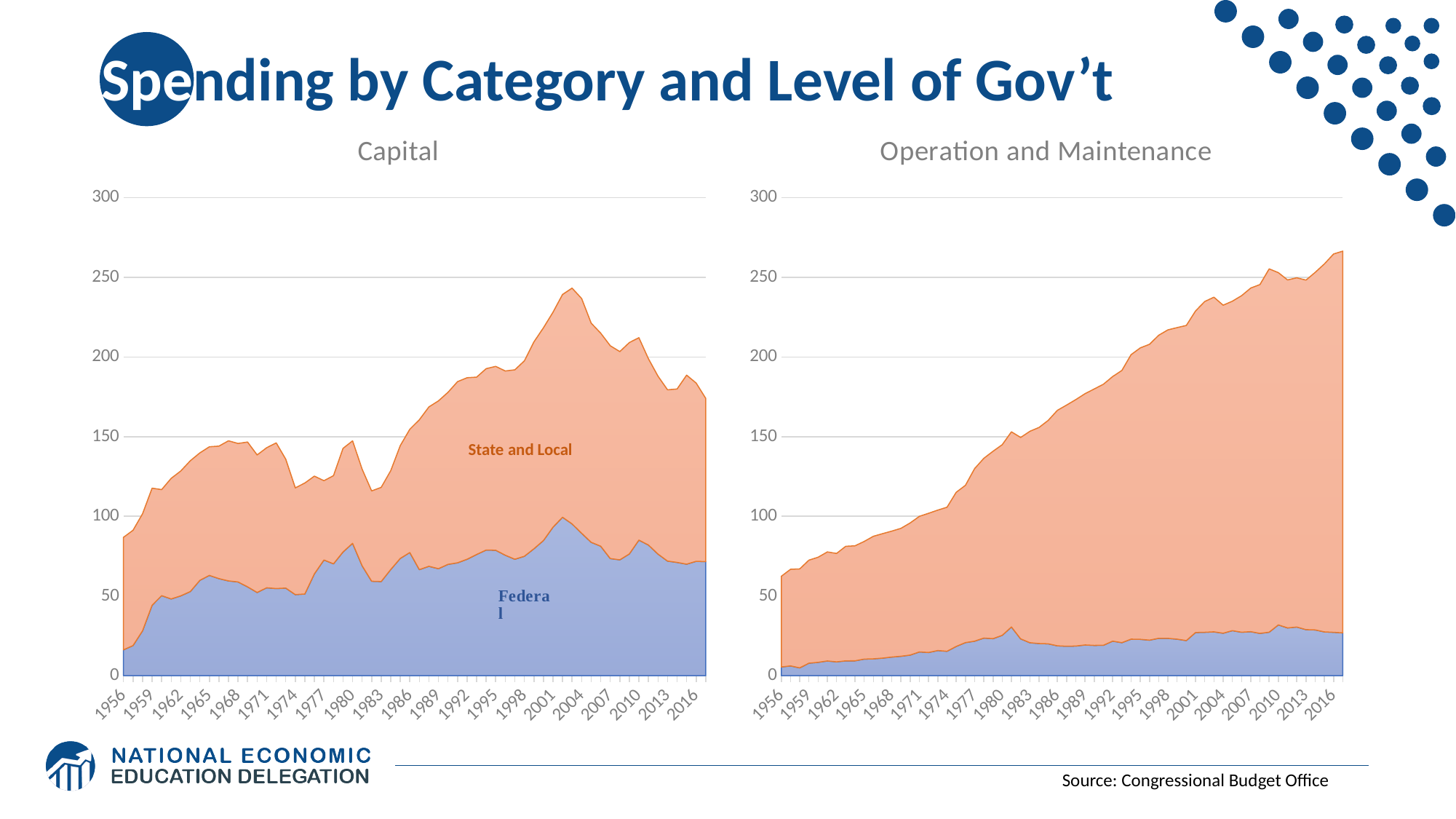
In the Capital chart, is the total (top of the stacked area) in 2004 greater or less than 200? greater In the Capital chart, is the Federal value in 2016 greater or less than 50? greater In the Capital chart, which series is larger in 2016, State and Local or Federal? State and Local In the Operation and Maintenance chart, is the Federal value in 2016 greater or less than 50? less What kind of chart is the Capital chart? stacked area chart How many series are shown in the Capital chart? 2 What is the title of the right-hand chart? Operation and Maintenance Which chart shows the larger total in 2016, Capital or Operation and Maintenance? Operation and Maintenance In the Capital chart, which two series are labelled? State and Local, Federal In the Operation and Maintenance chart, does the total spending generally rise or fall from 1956 to 2016? rise